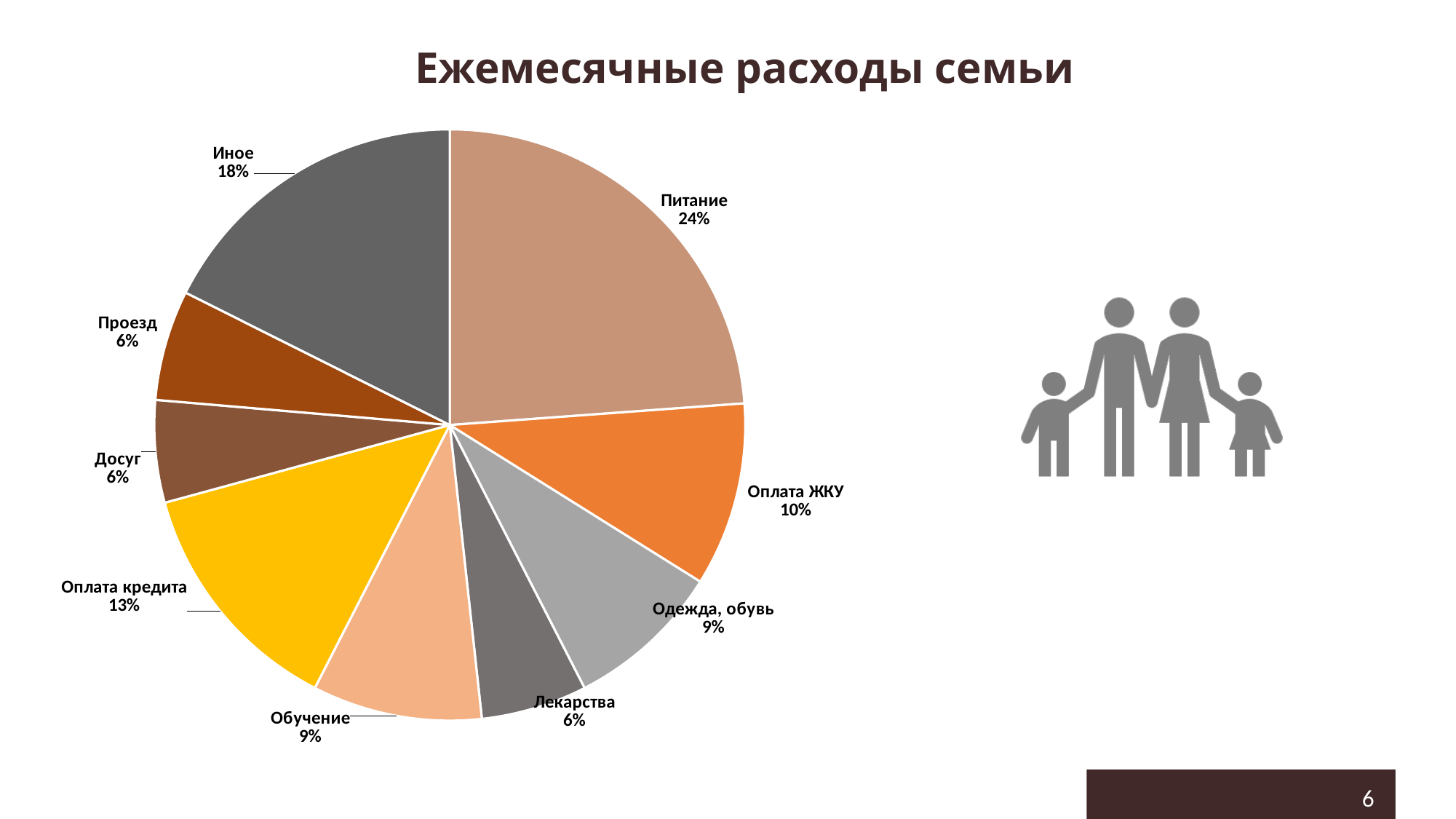
Which category has the largest share of monthly family expenses? Питание What is the title of the chart? Ежемесячные расходы семьи What is the difference in percentage points between Питание and Иное? 6 What percentage is shown for Оплата ЖКУ? 10% What is the combined share of Проезд, Досуг and Лекарства? 18% What percentage is shown for Одежда, обувь? 9% What share of monthly family expenses goes to Питание? 24% Which is larger, the share for Оплата кредита or the share for Обучение? Оплата кредита What type of chart is shown on the slide? Pie chart What percentage is shown for Оплата кредита? 13% How many categories are shown in the pie chart? 9 What share does the Иное slice represent? 18%